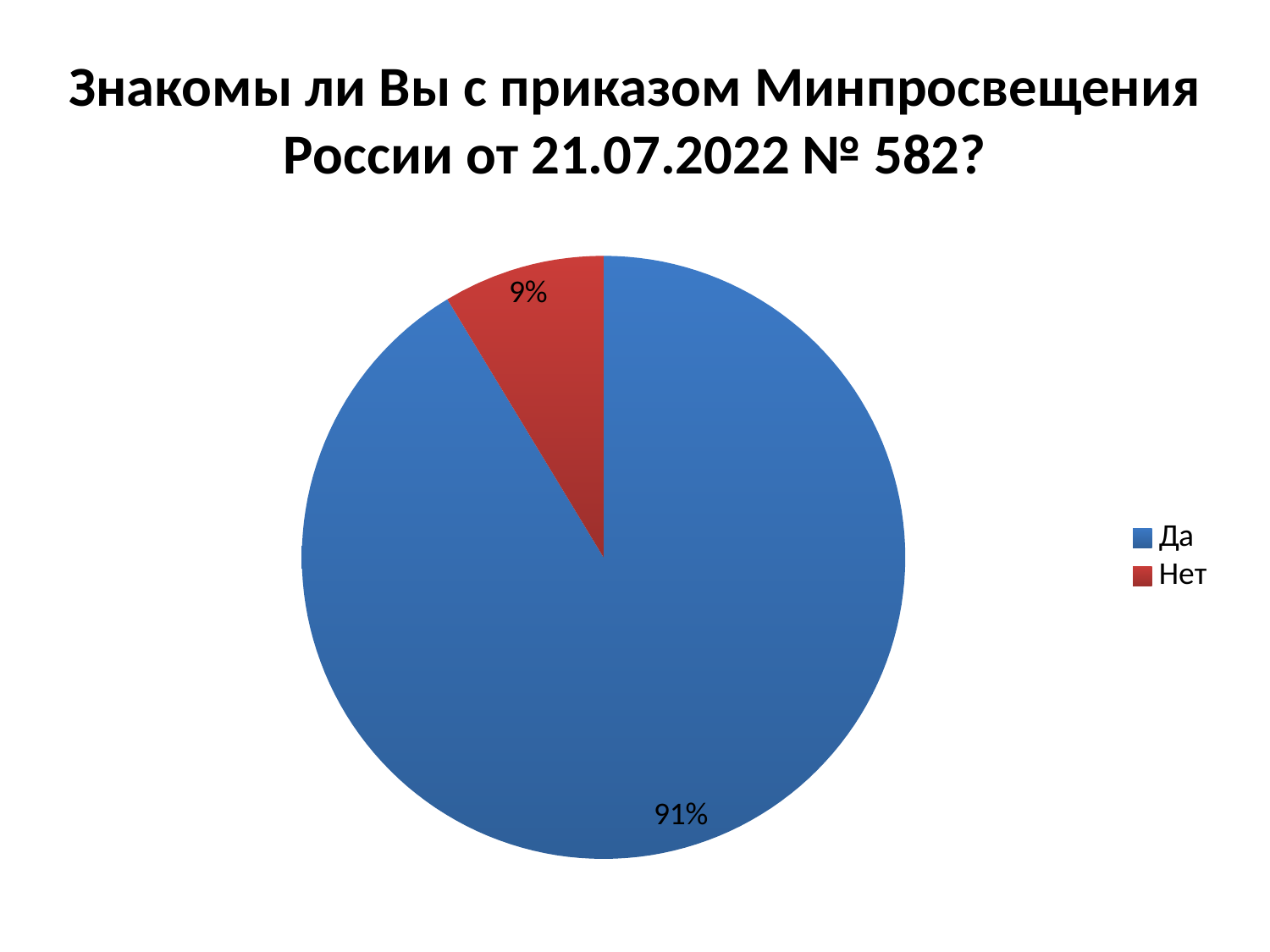
What share of the pie does "Да" represent? 91% What colour is the "Нет" slice? red How many entries does the legend list? 2 What kind of chart is shown on the slide? pie chart Which category has the smallest slice of the pie? Нет Which slice is larger, "Да" or "Нет"? Да How many categories are shown in the pie chart? 2 What is the difference in percentage points between the "Да" and "Нет" slices? 82 What share of the pie does "Нет" represent? 9% What is the title of the chart? Знакомы ли Вы с приказом Минпросвещения России от 21.07.2022 № 582? Which category has the largest slice of the pie? Да